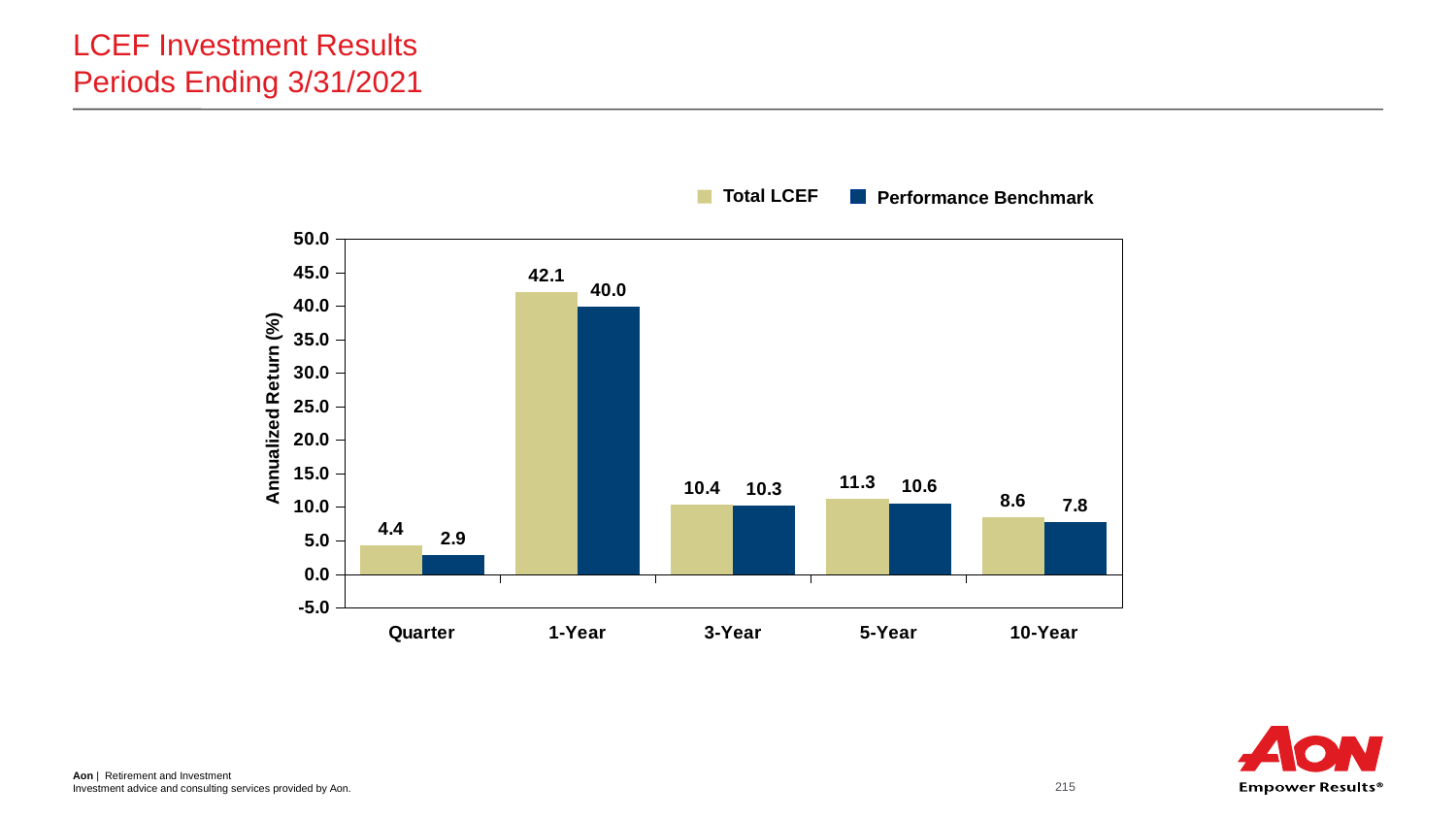
What is the Performance Benchmark value for the 10-Year period? 7.8 How many periods are shown on the x axis? 5 What is the difference between the Total LCEF and Performance Benchmark values for the 1-Year period? 2.1 What is the label of the y axis? Annualized Return (%) Which period has the highest Total LCEF value? 1-Year How many series does the legend list? 2 What is the Performance Benchmark value for the Quarter period? 2.9 Which is larger for the 5-Year period, Total LCEF or Performance Benchmark? Total LCEF What is the difference between the Total LCEF and Performance Benchmark values for the Quarter period? 1.5 What kind of chart is shown on the slide? Bar chart What is the Total LCEF value for the 1-Year period? 42.1 Which period has the lowest Performance Benchmark value? Quarter